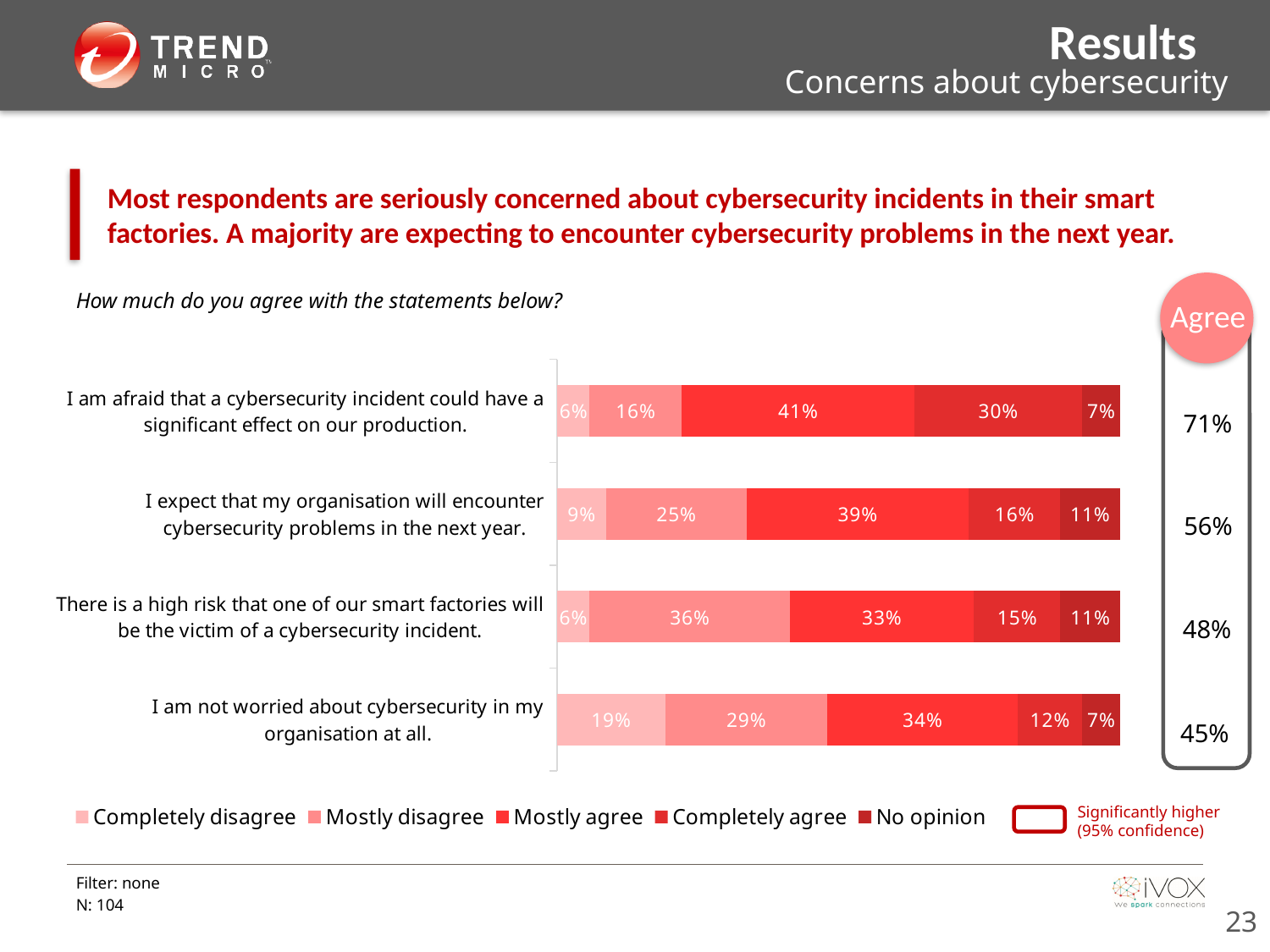
Which response category is shown in the darkest red in the legend? No opinion What is the difference in 'Agree' percentage between 'I am afraid that a cybersecurity incident could have a significant effect on our production.' and 'I am not worried about cybersecurity in my organisation at all.'? 26 percentage points Which statement has the lowest 'Agree' percentage? I am not worried about cybersecurity in my organisation at all. What is the 'No opinion' share for the statement 'I expect that my organisation will encounter cybersecurity problems in the next year.'? 11% What percentage of respondents 'Mostly agree' with the statement 'I am afraid that a cybersecurity incident could have a significant effect on our production.'? 41% What kind of chart is shown on the slide? Stacked bar chart How many response categories does the legend list? 5 Which statement has a larger 'Mostly disagree' share: 'There is a high risk that one of our smart factories will be the victim of a cybersecurity incident.' or 'I expect that my organisation will encounter cybersecurity problems in the next year.'? There is a high risk that one of our smart factories will be the victim of a cybersecurity incident. Which statement has the highest 'Agree' percentage? I am afraid that a cybersecurity incident could have a significant effect on our production. How many statements are shown in the chart? 4 What is the difference in 'Completely agree' share between 'I am afraid that a cybersecurity incident could have a significant effect on our production.' and 'I am not worried about cybersecurity in my organisation at all.'? 18 percentage points What percentage of respondents 'Completely disagree' with the statement 'I am not worried about cybersecurity in my organisation at all.'? 19%